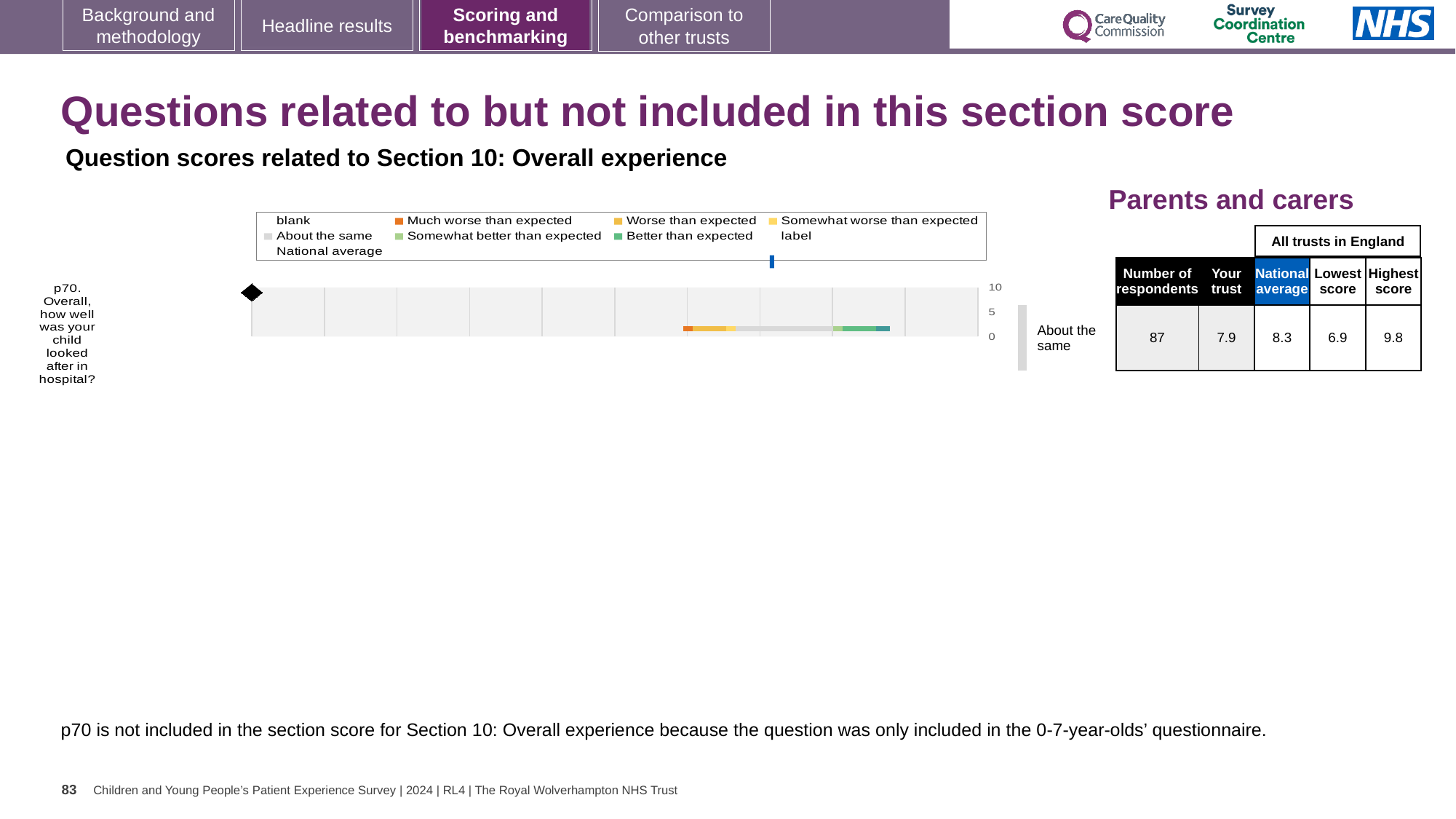
In the table beside the chart, what is the 'Your trust' score for p70? 7.9 What kind of chart is shown on the slide? bar chart In the table beside the chart, what is the lowest score among all trusts in England for p70? 6.9 In the table beside the chart, what is the number of respondents for p70? 87 Which question is plotted in the chart? p70. Overall, how well was your child looked after in hospital? How many question categories are plotted in the chart? 1 What category label is shown to the right of the chart for p70? About the same In the table beside the chart, what is the National average score for p70? 8.3 In the table beside the chart, which is larger for p70: the 'Your trust' score or the National average? National average How many entries does the chart legend list? 9 In the table beside the chart, what is the highest score among all trusts in England for p70? 9.8 What is the highest value shown on the chart's axis? 10